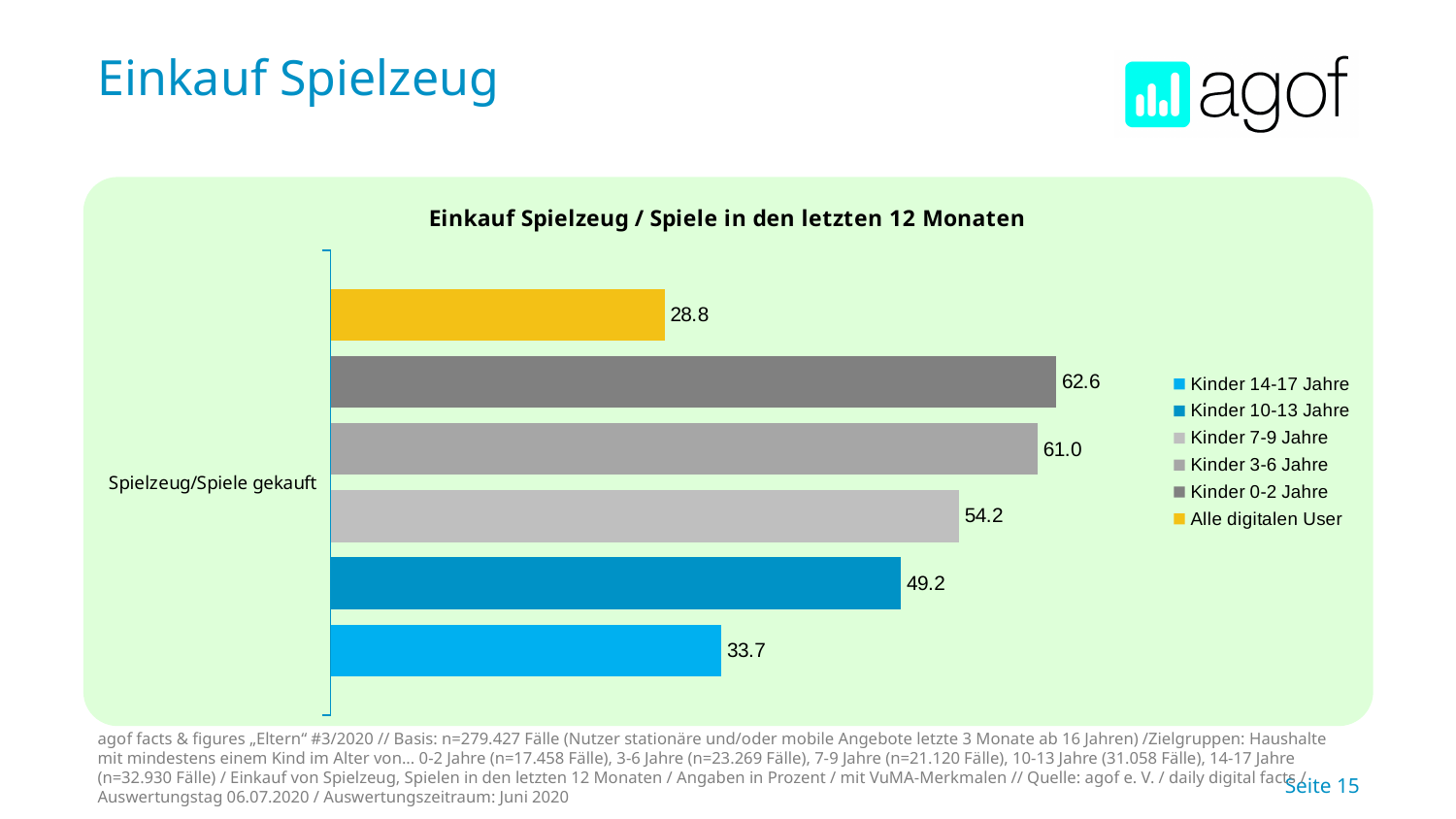
Which series has the highest value? Kinder 0-2 Jahre What is the title of the chart? Einkauf Spielzeug / Spiele in den letzten 12 Monaten What kind of chart is shown? Bar chart What is the value for Kinder 14-17 Jahre? 33.7 What is the value for Kinder 0-2 Jahre? 62.6 What is the difference between the values for Kinder 0-2 Jahre and Kinder 3-6 Jahre? 1.6 What is the value for Alle digitalen User? 28.8 Which is larger, the value for Kinder 7-9 Jahre or the value for Kinder 10-13 Jahre? Kinder 7-9 Jahre How many series does the legend list? 6 Which series has the lowest value? Alle digitalen User What is the value for Kinder 7-9 Jahre? 54.2 What is the difference between the values for Kinder 10-13 Jahre and Kinder 14-17 Jahre? 15.5